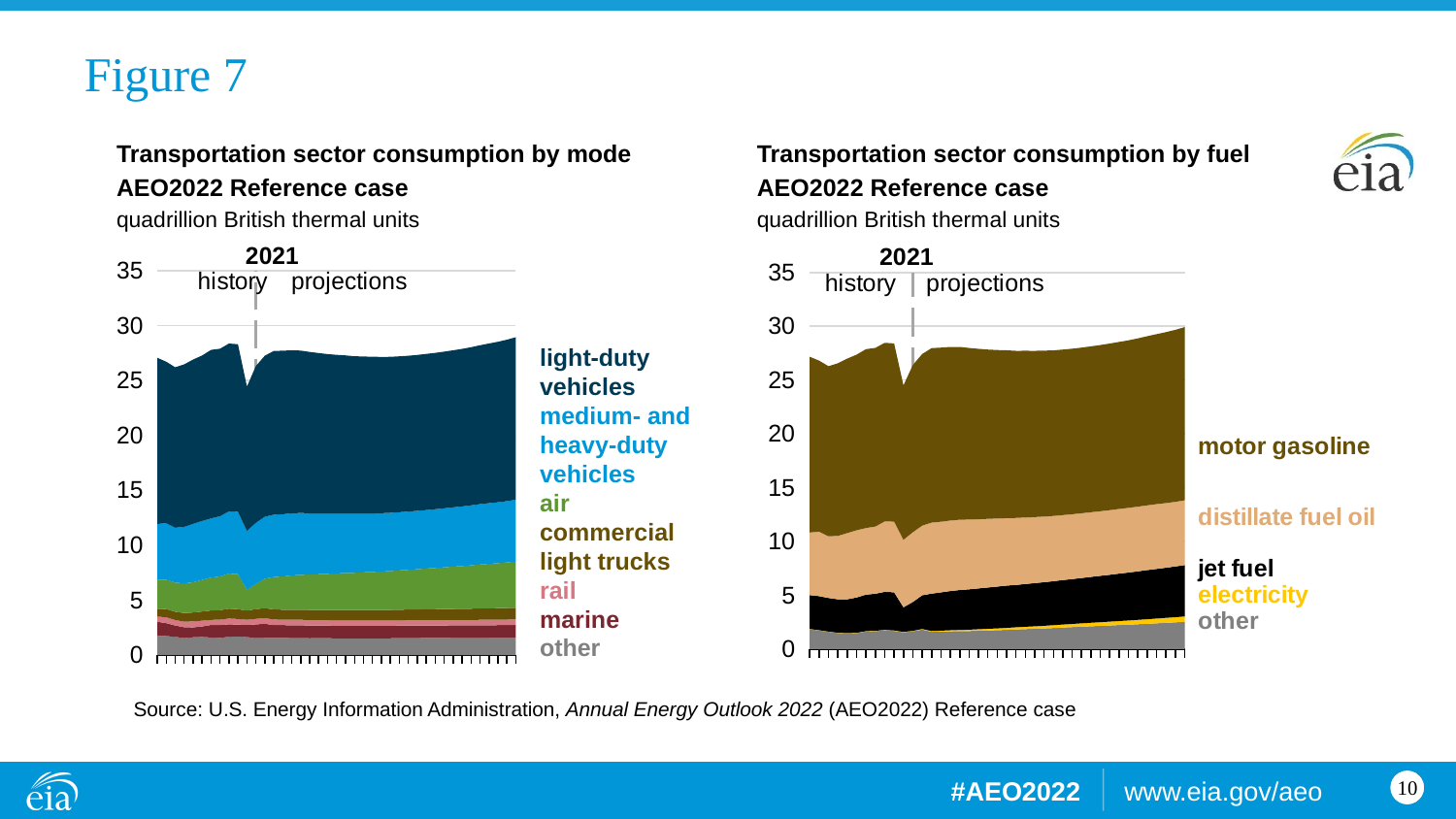
What unit of measurement is used on both charts? quadrillion British thermal units How many series are labeled on the 'Transportation sector consumption by fuel' chart? 5 Which year separates history from projections on both charts? 2021 What kind of chart is the 'Transportation sector consumption by mode' chart on the left? stacked area chart In the 'Transportation sector consumption by fuel' chart, which fuel accounts for the smallest share of consumption? electricity In the 'Transportation sector consumption by mode' chart, which mode accounts for the largest share of consumption? light-duty vehicles In the 'Transportation sector consumption by mode' chart, does total consumption rise or fall over the projection period? rise In the 'Transportation sector consumption by mode' chart, is total consumption at the start of the history period greater or less than 25? greater In the 'Transportation sector consumption by fuel' chart, which fuel accounts for the largest share of consumption? motor gasoline In the 'Transportation sector consumption by fuel' chart, is total consumption at the end of the projection period greater or less than 20? greater What kind of chart is the 'Transportation sector consumption by fuel' chart on the right? stacked area chart How many series are labeled on the 'Transportation sector consumption by mode' chart? 7